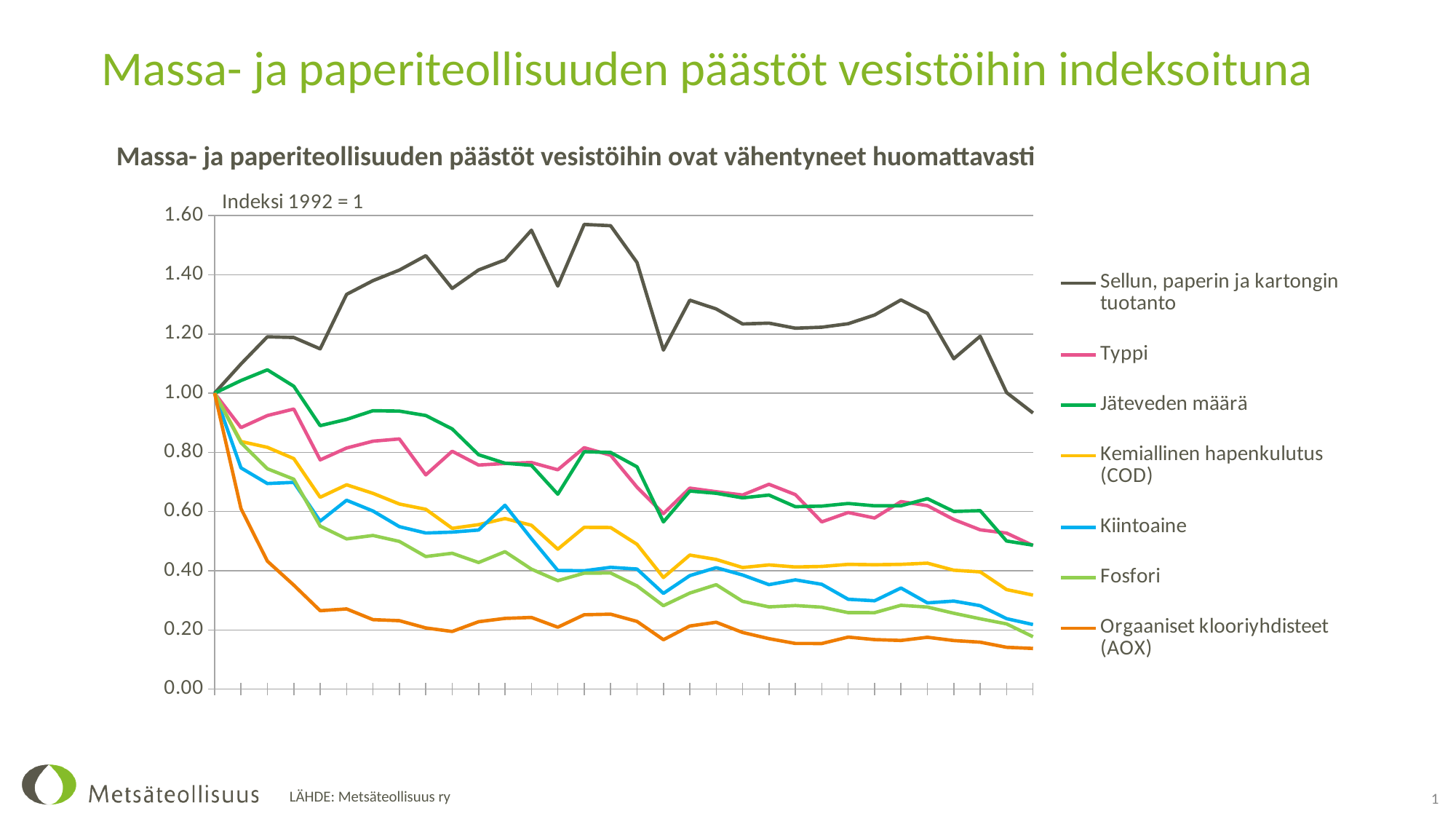
Which year is the base year of the index, according to the chart? 1992 How many series does the legend list? 7 Is the peak value of Sellun, paperin ja kartongin tuotanto greater or less than 1.40? greater Which series reaches the highest value on the chart? Sellun, paperin ja kartongin tuotanto Is the final value of Jäteveden määrä greater or less than 0.60? less What kind of chart is shown on the slide? line chart What index value do all series share at the start of the chart? 1 Is the final value of Orgaaniset klooriyhdisteet (AOX) greater or less than 0.20? less At the right end of the chart, is Kemiallinen hapenkulutus (COD) higher or lower than Kiintoaine? higher Which series lies lowest on the chart across most of the period? Orgaaniset klooriyhdisteet (AOX) Does the Typpi line rise or fall from the start to the end of the period? fall